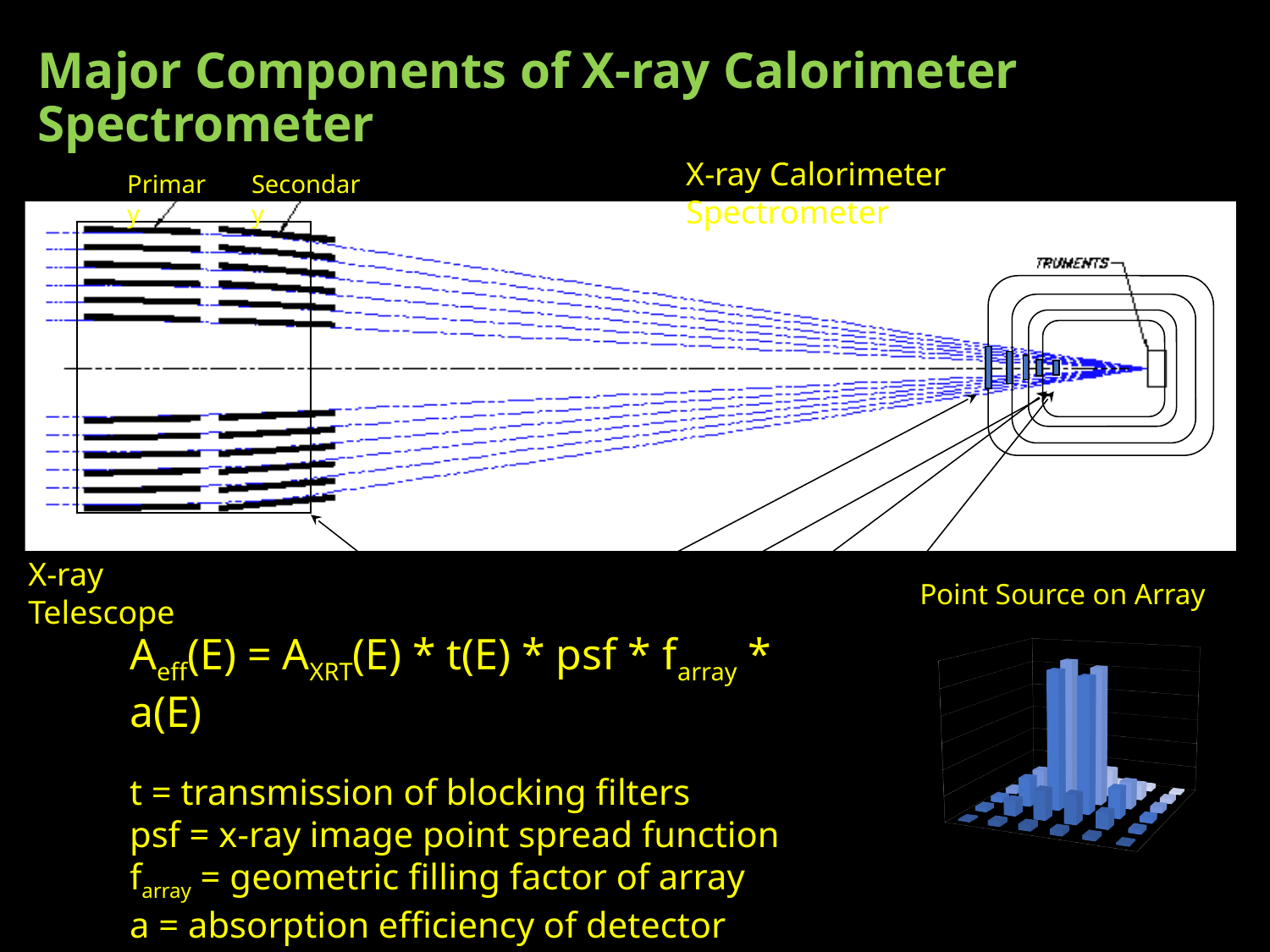
What colour are the bars in the "Point Source on Array" chart? blue What kind of chart is shown under the heading "Point Source on Array"? bar chart What is the title above the chart in the lower right of the slide? Point Source on Array In the "Point Source on Array" chart, where on the array are the tallest bars located? in the center